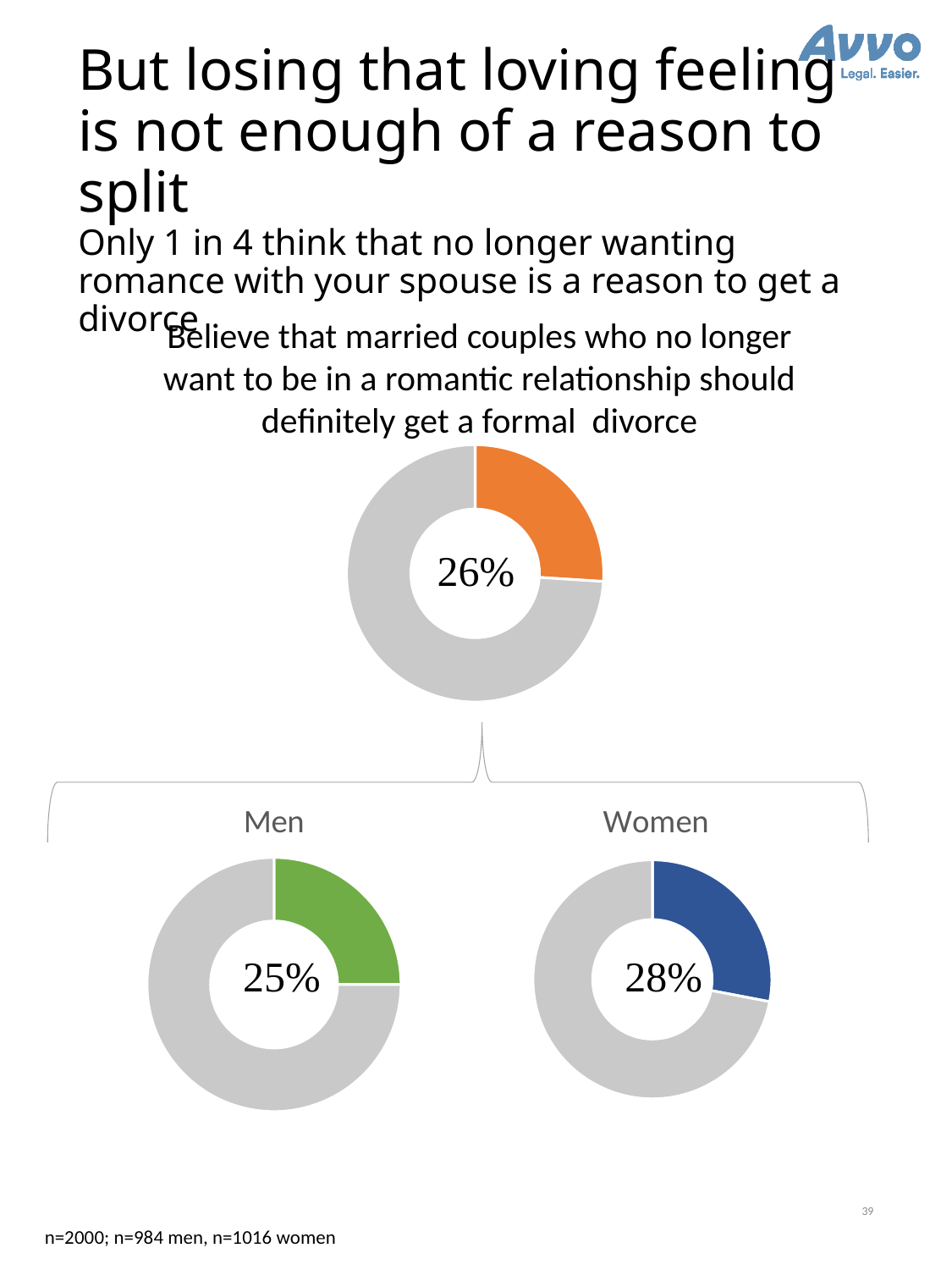
What kind of chart is used to show the percentages on this slide? Donut (pie) chart Comparing the Men and Women donut charts, which group has the higher percentage? Women What colour is the highlighted slice in the Women donut chart? Blue What is the difference between the percentage in the Women donut chart and the percentage in the top overall donut chart? 2% Is the percentage in the Men donut chart greater or less than 50%? less What colour is the highlighted slice in the Men donut chart? Green How many donut charts are shown on the slide? 3 In the Women donut chart, what percentage is shown? 28% In the Men donut chart, what percentage is shown? 25% What is the difference between the percentage in the Women donut chart and the percentage in the Men donut chart? 3% Comparing the Men and Women donut charts, which group has the lower percentage? Men What percentage is shown in the top donut chart for all respondents who believe married couples who no longer want a romantic relationship should definitely get a formal divorce? 26%